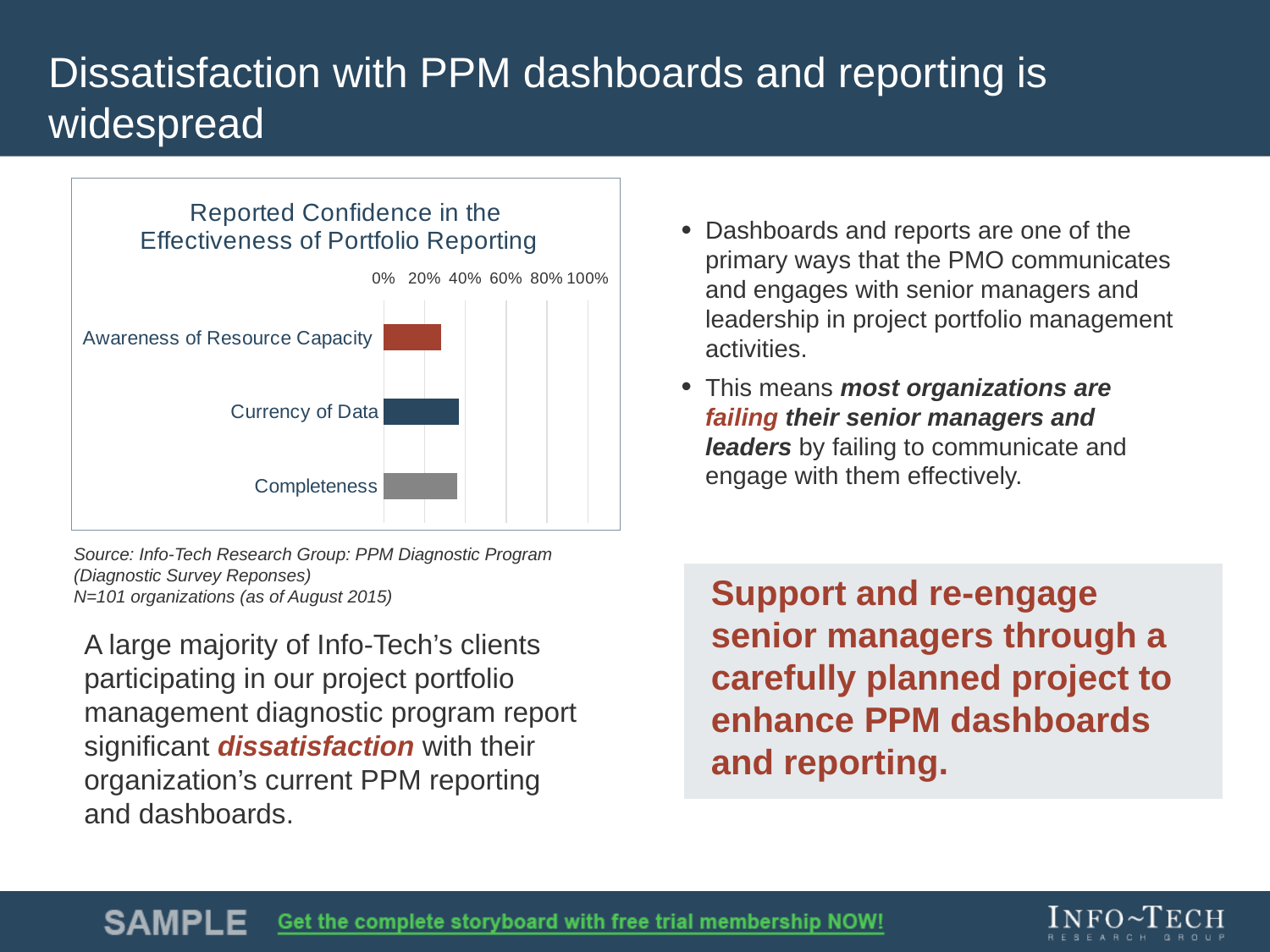
What is the highest value shown on the chart's percentage axis? 100% Is the value for Completeness greater or less than 60%? less What kind of chart is shown on the slide? Bar chart Which is larger, the value for Currency of Data or the value for Awareness of Resource Capacity? Currency of Data Is the value for Awareness of Resource Capacity greater or less than 40%? less Is the value for Awareness of Resource Capacity greater or less than 20%? greater What is the title of the chart? Reported Confidence in the Effectiveness of Portfolio Reporting Which category has the lowest reported confidence? Awareness of Resource Capacity How many categories are plotted in the chart? 3